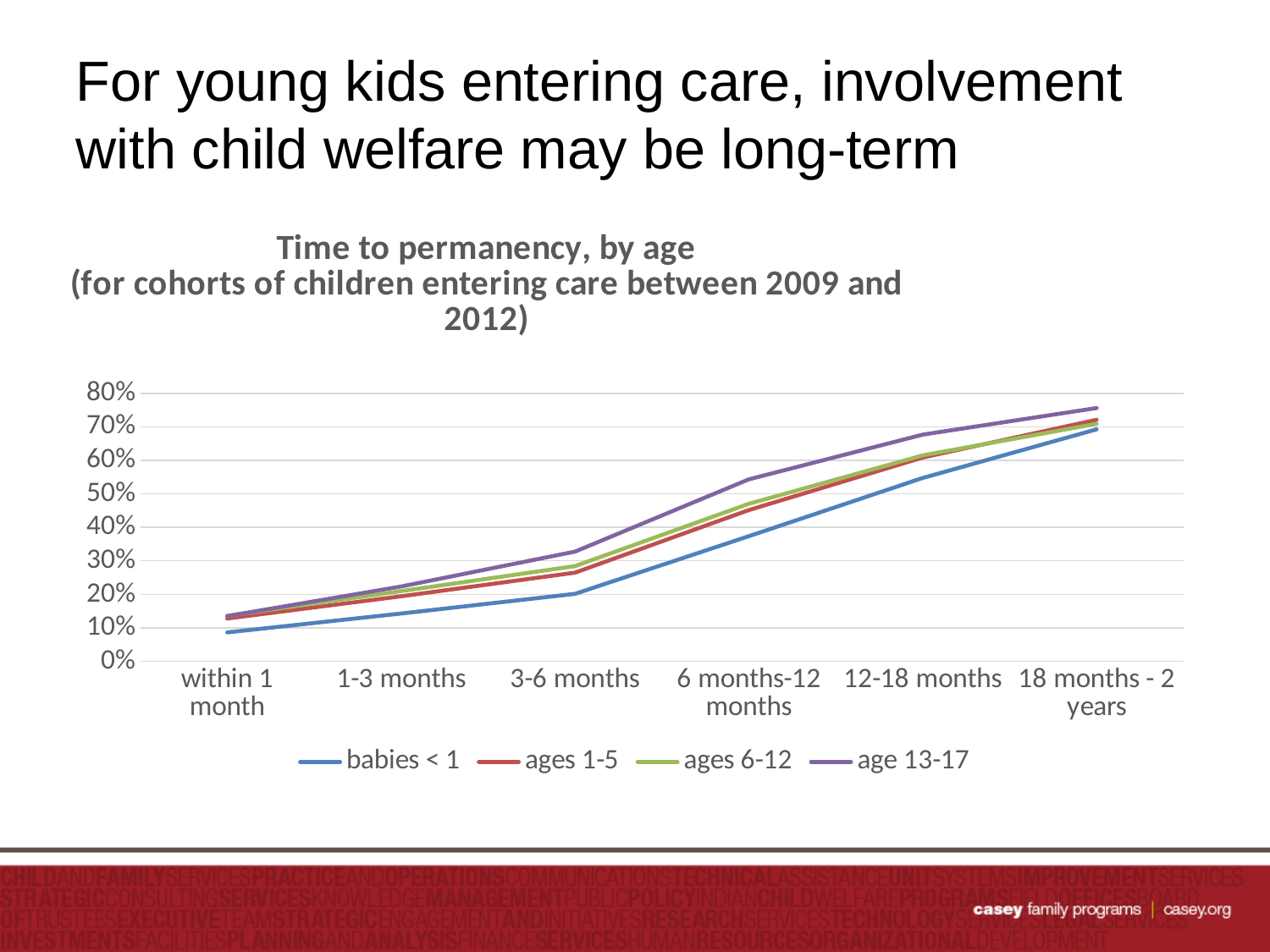
What is the first line of the chart's title? Time to permanency, by age What kind of chart is shown on the slide? line chart Is the value for babies < 1 at '12-18 months' greater or less than 50%? greater Do the values for the babies < 1 series rise or fall from 'within 1 month' to '18 months - 2 years'? rise At '3-6 months', which is larger: the value for age 13-17 or the value for babies < 1? age 13-17 Is the value for age 13-17 at '18 months - 2 years' greater or less than 70%? greater Is the value for age 13-17 at '6 months-12 months' greater or less than 40%? greater How many time categories are shown along the x axis? 6 Which series has the highest value at '18 months - 2 years'? age 13-17 Which series has the lowest value at '6 months-12 months'? babies < 1 How many series does the legend list? 4